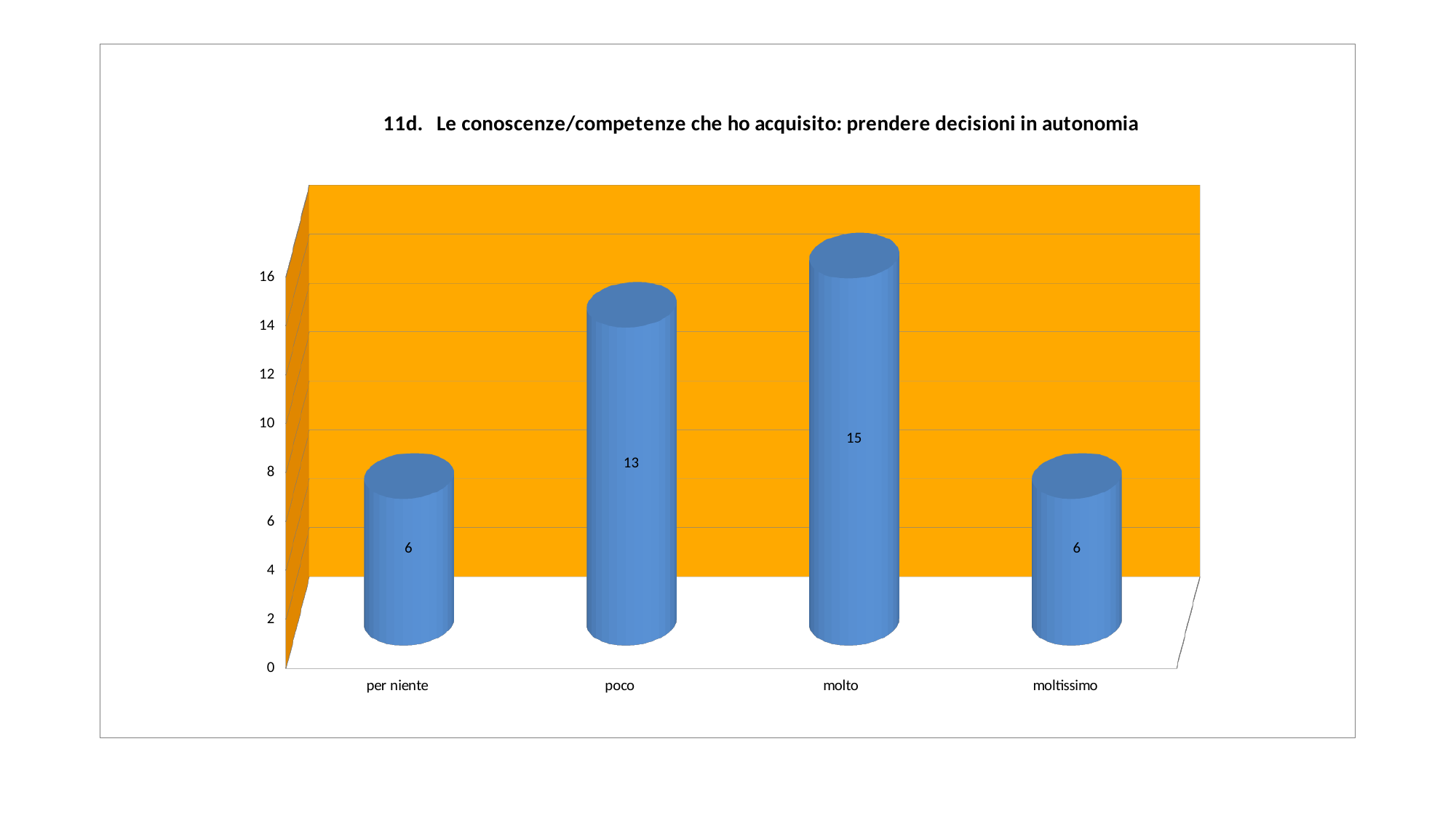
Which category has the highest value? molto What is the value for "per niente"? 6 What is the difference between the values for "poco" and "per niente"? 7 What is the title of the chart? 11d. Le conoscenze/competenze che ho acquisito: prendere decisioni in autonomia What is the value for "moltissimo"? 6 What is the value for "poco"? 13 Is the value for "molto" greater or less than 10? greater What is the value for "molto"? 15 What is the difference between the values for "molto" and "poco"? 2 Which is larger, the value for "poco" or the value for "moltissimo"? poco How many categories are shown on the x axis? 4 What kind of chart is shown on the slide? bar chart